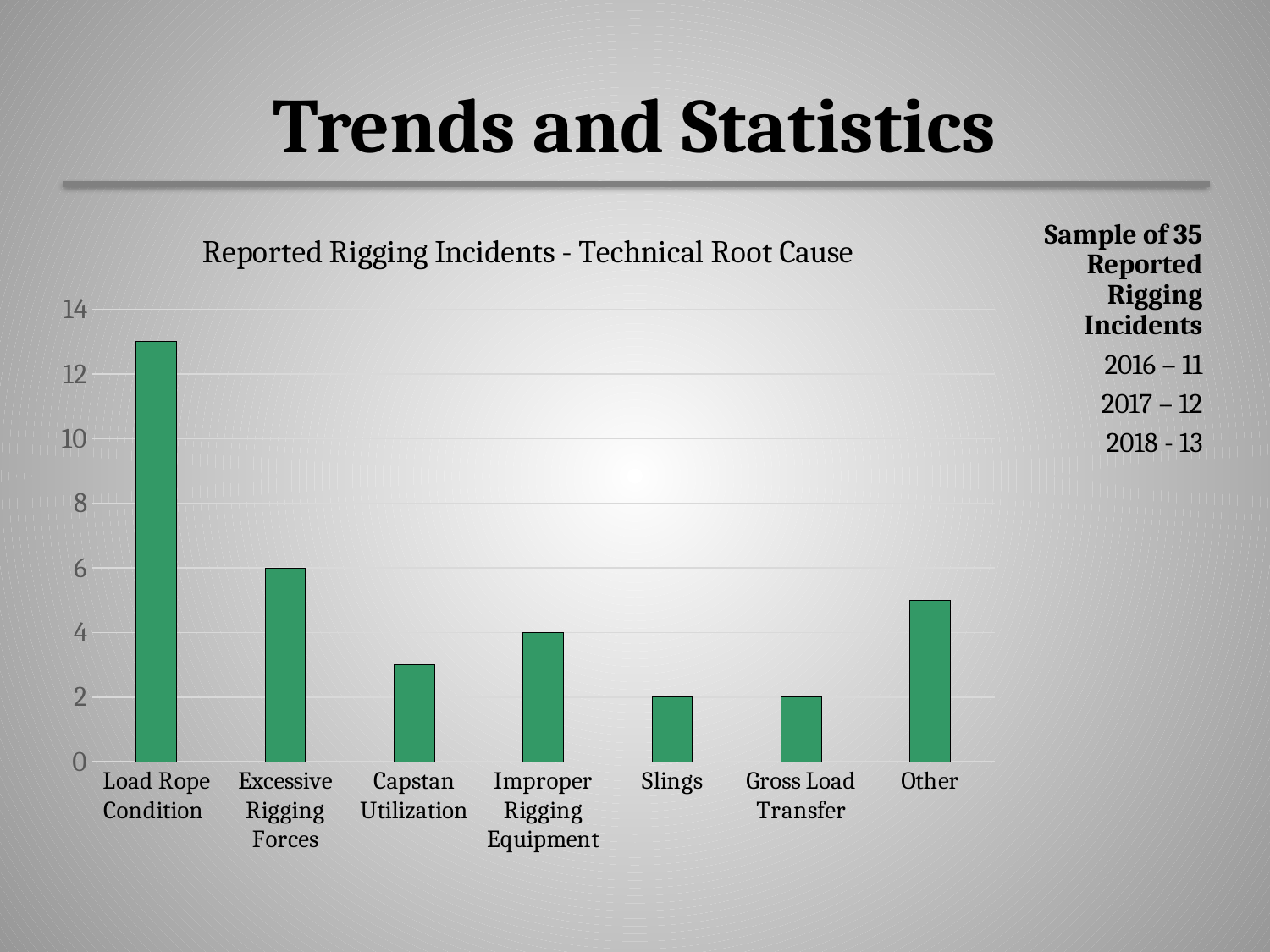
Is the value for Load Rope Condition greater or less than 12? greater What is the value for Gross Load Transfer? 2 What is the value for Improper Rigging Equipment? 4 What is the title of the chart? Reported Rigging Incidents - Technical Root Cause What is the value for Excessive Rigging Forces? 6 What type of chart is shown on the slide? bar chart Is the value for Other greater or less than 4? greater Which category has the highest number of reported rigging incidents? Load Rope Condition Is the value for Capstan Utilization greater or less than 4? less What is the value for Slings? 2 What is the difference between the values for Excessive Rigging Forces and Improper Rigging Equipment? 2 How many technical root cause categories are shown in the chart? 7